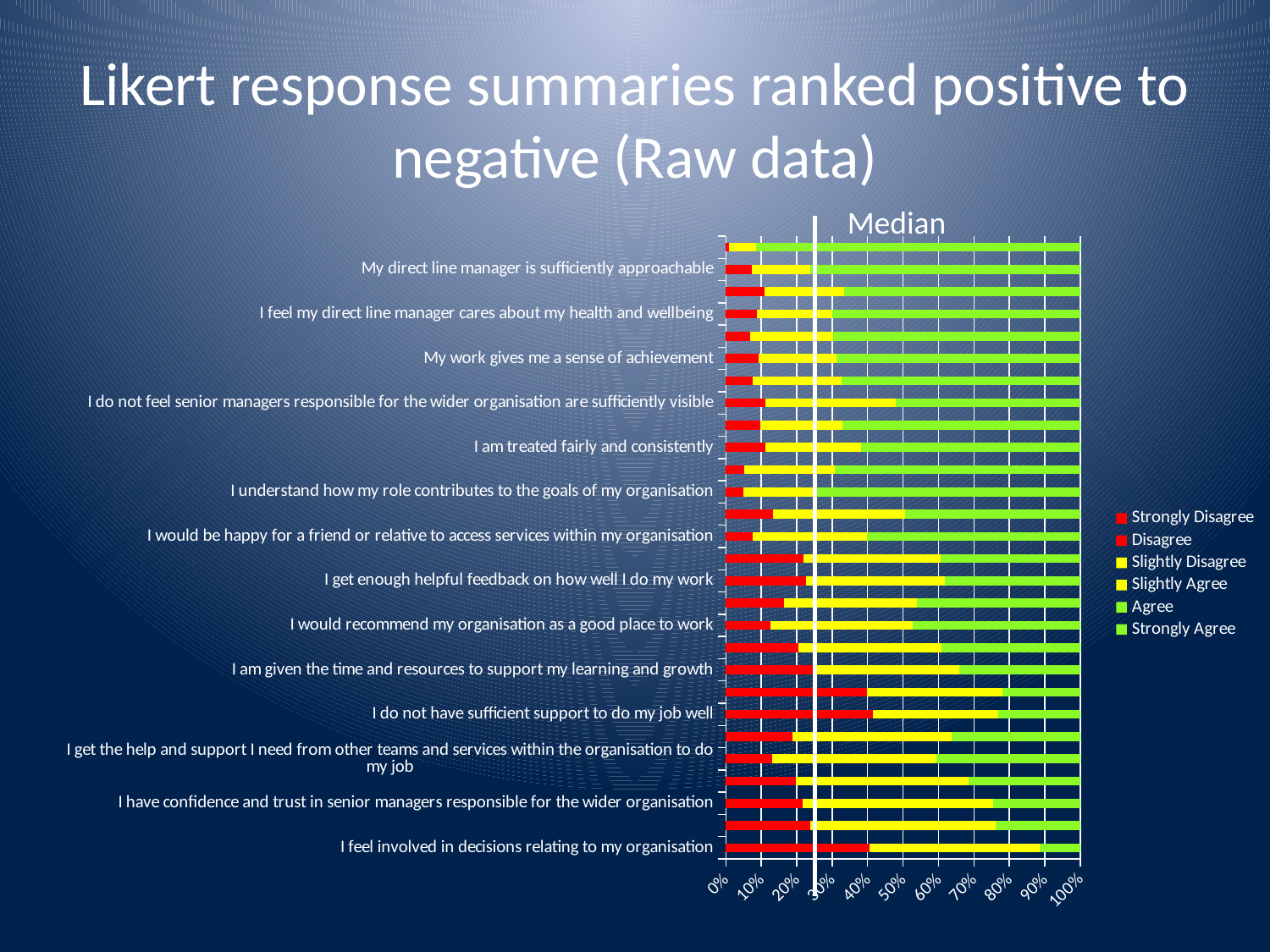
Is the red (disagree) portion of the bar for 'I do not have sufficient support to do my job well' greater or less than 30%? greater What kind of chart is shown on the slide? Stacked bar chart What is the title of the slide's chart? Likert response summaries ranked positive to negative (Raw data) Which has the larger red (disagree) portion: 'I feel involved in decisions relating to my organisation' or 'My direct line manager is sufficiently approachable'? I feel involved in decisions relating to my organisation Is the red (disagree) portion of the bar for 'My direct line manager is sufficiently approachable' greater or less than 10%? less Moving from the top of the chart to the bottom, does the red (disagree) portion of the bars generally increase or decrease? increase What does the vertical white line drawn across the chart represent? Median How many series does the legend list? 6 Is the red (disagree) portion of the bar for 'My work gives me a sense of achievement' greater or less than 20%? less What is the highest value shown on the horizontal axis? 100%